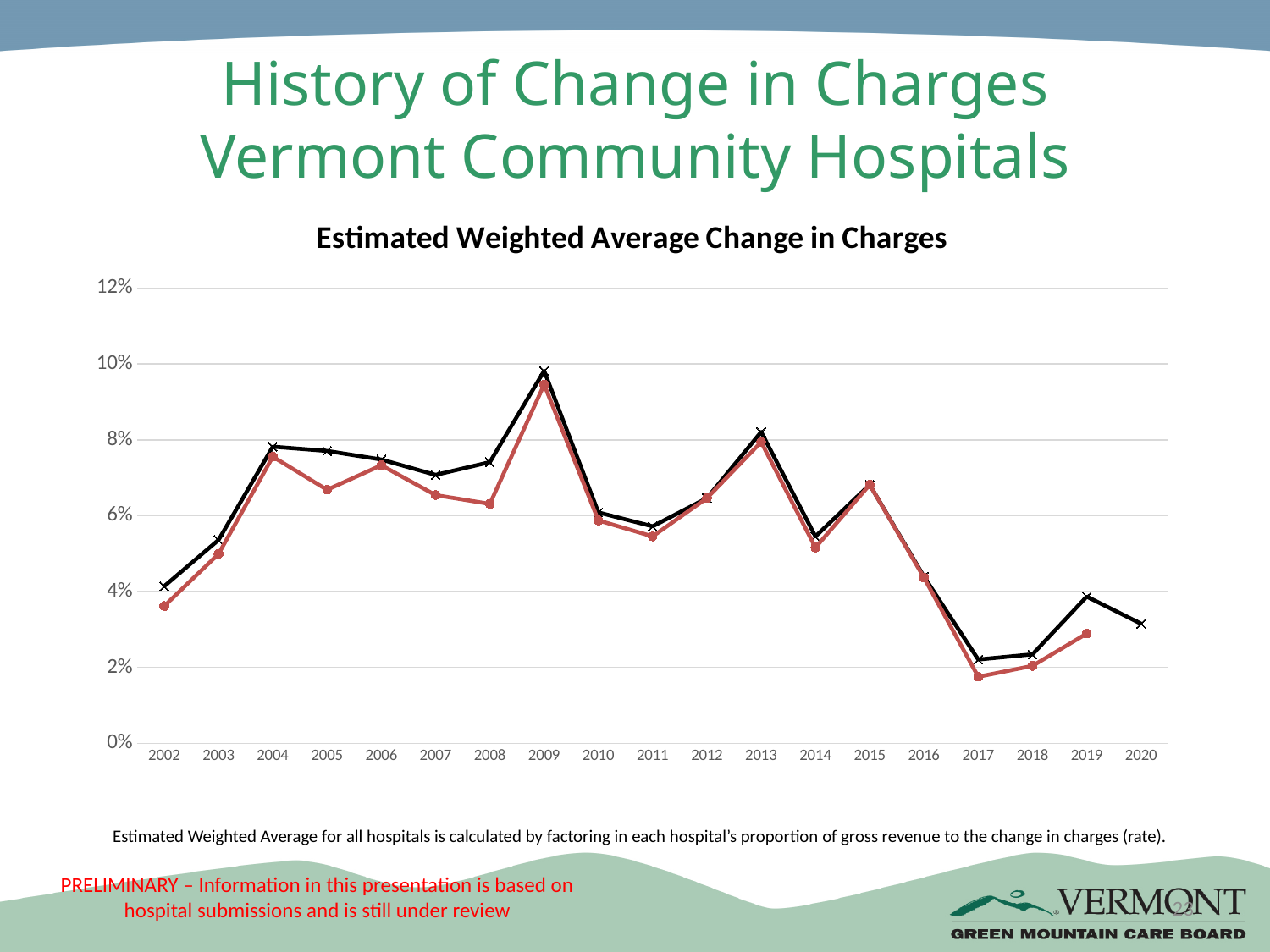
Is the value of the black line in 2009 greater or less than 8%? greater Is the value of the red line in 2017 greater or less than 2%? less In which year does the black line reach its highest value? 2009 How many years are plotted along the x axis of the chart? 19 Is the value of the black line in 2020 greater or less than 4%? less Does the black line rise or fall from 2015 to 2017? fall What kind of chart is shown on the slide? line chart For the black line, which year has the larger value, 2009 or 2013? 2009 For the red line, which year has the larger value, 2004 or 2005? 2004 In which year does the red line reach its highest value? 2009 What is the title of the chart? Estimated Weighted Average Change in Charges